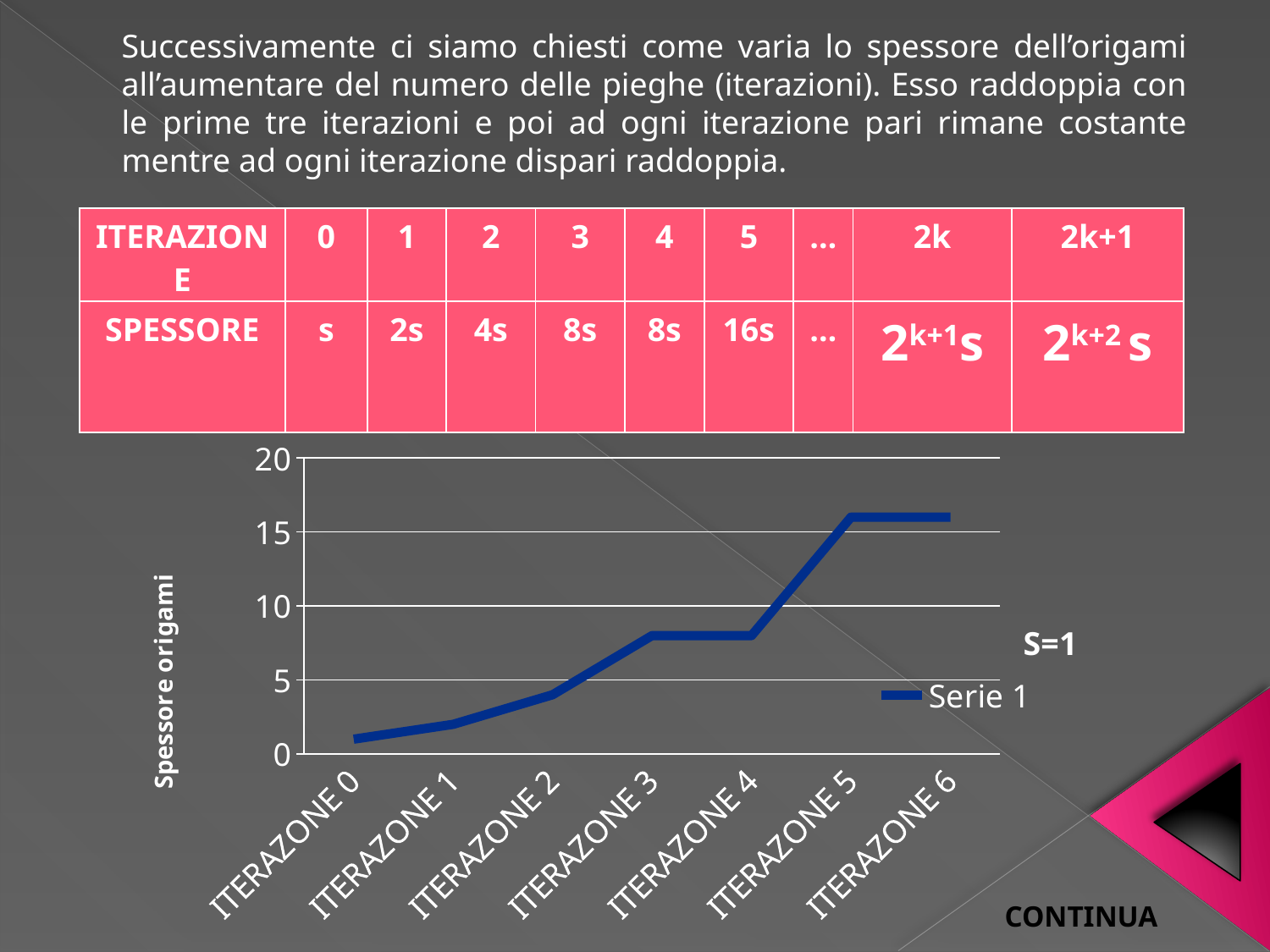
Is the value for ITERAZONE 0 greater or less than 5? less What is the title of the vertical axis of the chart? Spessore origami How many categories are plotted along the x axis of the chart? 7 Is the value for ITERAZONE 3 greater or less than 5? greater Which category has the lowest value in the chart? ITERAZONE 0 What kind of chart is shown on the slide? line chart Which has the larger value, ITERAZONE 2 or ITERAZONE 5? ITERAZONE 5 What is the name of the series shown in the chart legend? Serie 1 Is the value for ITERAZONE 5 greater or less than 10? greater Do the values generally rise or fall from ITERAZONE 0 to ITERAZONE 6? rise How many series does the chart legend list? 1